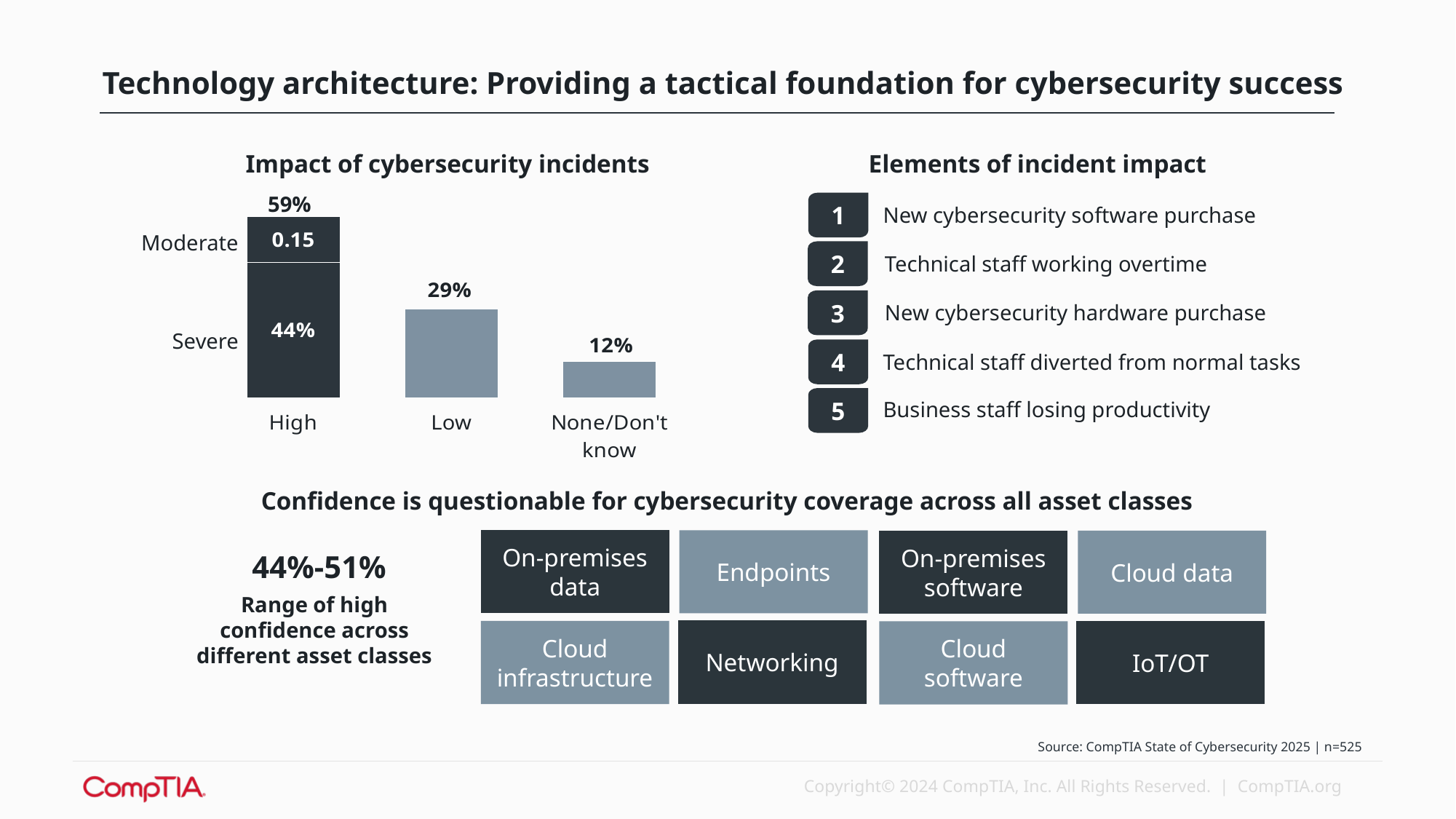
In the 'Impact of cybersecurity incidents' chart, which category has the highest value? High In the 'Impact of cybersecurity incidents' chart, what value is printed on the Severe segment of the High bar? 44% In the 'Impact of cybersecurity incidents' chart, what value is printed on the Moderate segment of the High bar? 0.15 In the 'Impact of cybersecurity incidents' chart, how many categories are shown on the x axis? 3 In the 'Impact of cybersecurity incidents' chart, do the values rise or fall from left to right across the categories? Fall In the 'Impact of cybersecurity incidents' chart, what is the value for Low? 29% In the 'Impact of cybersecurity incidents' chart, what is the difference between the Low value and the None/Don't know value? 17% In the 'Impact of cybersecurity incidents' chart, what is the difference between the High total and the Low value? 30% In the 'Impact of cybersecurity incidents' chart, what is the value for None/Don't know? 12% In the 'Impact of cybersecurity incidents' chart, which category has the lowest value? None/Don't know In the 'Impact of cybersecurity incidents' chart, what is the total value shown above the High bar? 59% What type of chart is 'Impact of cybersecurity incidents'? Bar chart